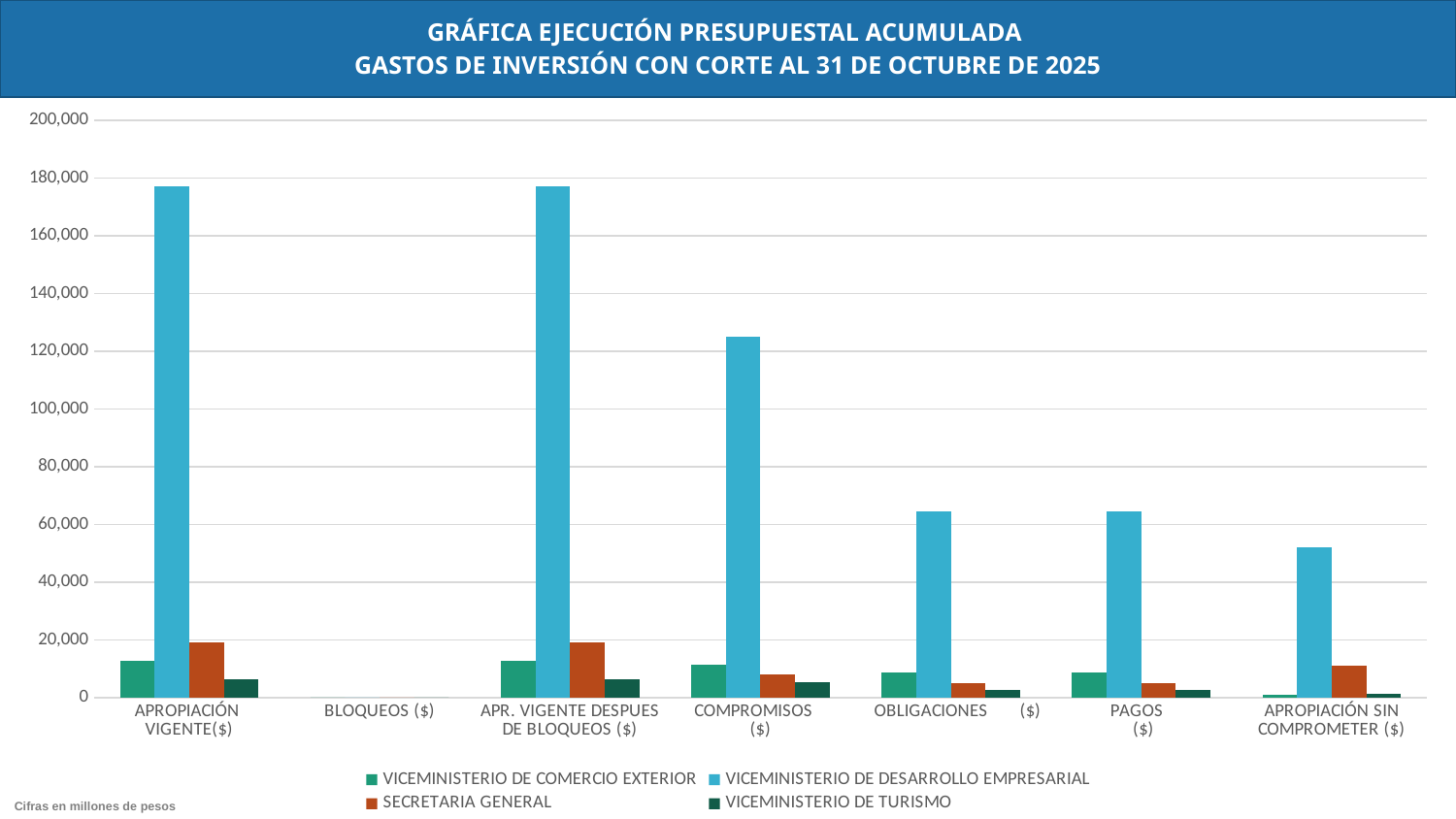
How many categories are shown along the x axis? 7 Is the value for VICEMINISTERIO DE DESARROLLO EMPRESARIAL in APROPIACIÓN VIGENTE($) greater or less than 160,000? greater Which series has the highest value in the COMPROMISOS ($) category? VICEMINISTERIO DE DESARROLLO EMPRESARIAL Is the value for VICEMINISTERIO DE DESARROLLO EMPRESARIAL in APROPIACIÓN SIN COMPROMETER ($) greater or less than 40,000? greater Is the value for VICEMINISTERIO DE DESARROLLO EMPRESARIAL in OBLIGACIONES ($) greater or less than 80,000? less Which series has the lowest value in the APROPIACIÓN VIGENTE($) category? VICEMINISTERIO DE TURISMO For VICEMINISTERIO DE DESARROLLO EMPRESARIAL, which is larger: COMPROMISOS ($) or OBLIGACIONES ($)? COMPROMISOS ($) What kind of chart is shown on the slide? bar chart Do the values for VICEMINISTERIO DE DESARROLLO EMPRESARIAL rise or fall from APR. VIGENTE DESPUES DE BLOQUEOS ($) to PAGOS ($)? fall In APROPIACIÓN VIGENTE($), which is larger: SECRETARIA GENERAL or VICEMINISTERIO DE COMERCIO EXTERIOR? SECRETARIA GENERAL How many series does the legend list? 4